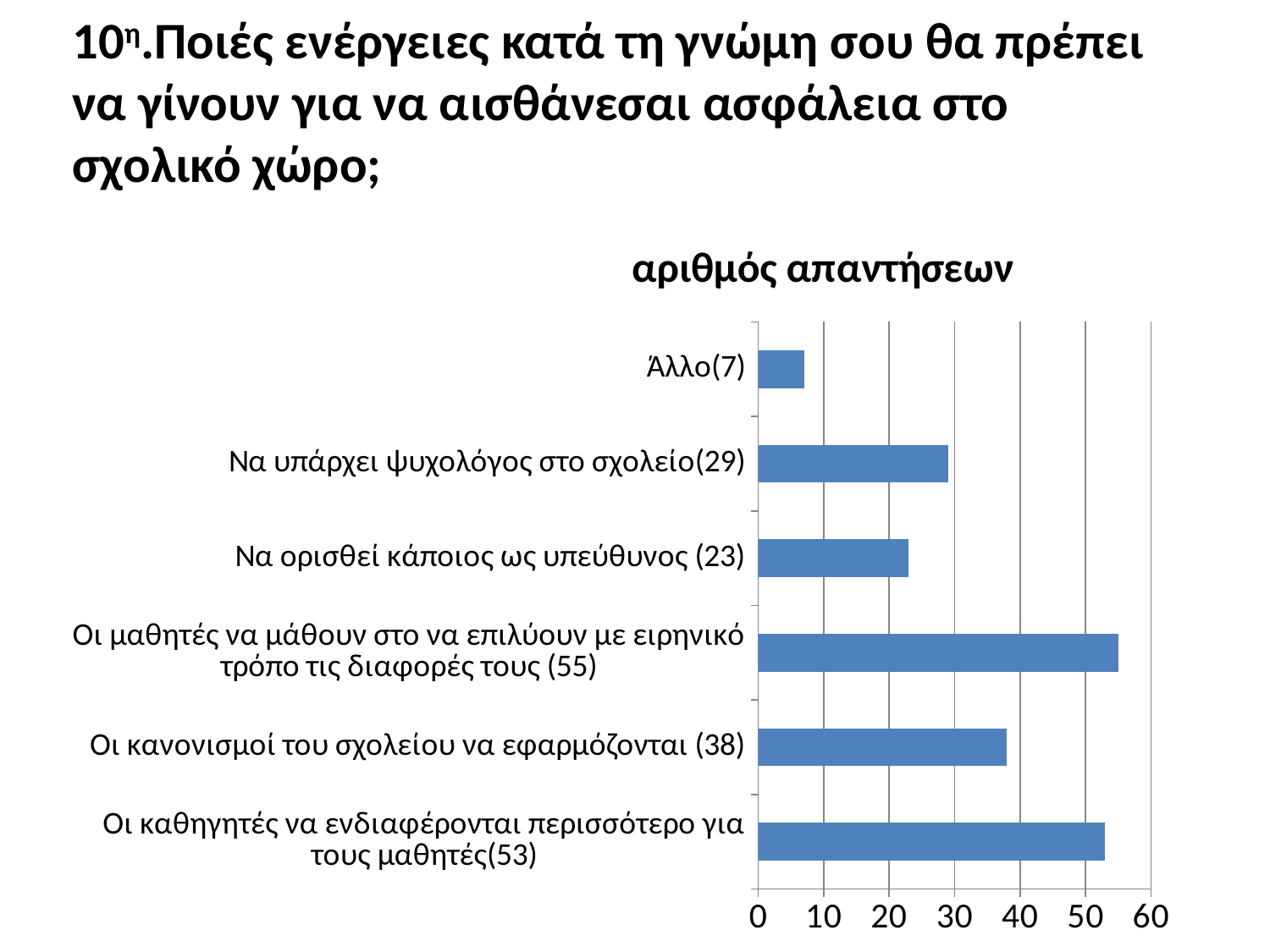
Which category has the lowest number of responses? Άλλο(7) Which has more responses: 'Να ορισθεί κάποιος ως υπεύθυνος' or 'Να υπάρχει ψυχολόγος στο σχολείο'? Να υπάρχει ψυχολόγος στο σχολείο Which category has the highest number of responses? Οι μαθητές να μάθουν στο να επιλύουν με ειρηνικό τρόπο τις διαφορές τους (55) How many responses are shown for 'Να υπάρχει ψυχολόγος στο σχολείο'? 29 Is the value for 'Οι κανονισμοί του σχολείου να εφαρμόζονται' greater or less than 40? less How many responses are shown for 'Οι κανονισμοί του σχολείου να εφαρμόζονται'? 38 What is the title of the chart? αριθμός απαντήσεων How many categories does the chart show? 6 What kind of chart is shown on the slide? bar chart How many responses are shown for 'Άλλο'? 7 What is the difference between the responses for 'Οι μαθητές να μάθουν στο να επιλύουν με ειρηνικό τρόπο τις διαφορές τους' and 'Οι καθηγητές να ενδιαφέρονται περισσότερο για τους μαθητές'? 2 What is the difference between the responses for 'Οι κανονισμοί του σχολείου να εφαρμόζονται' and 'Να ορισθεί κάποιος ως υπεύθυνος'? 15